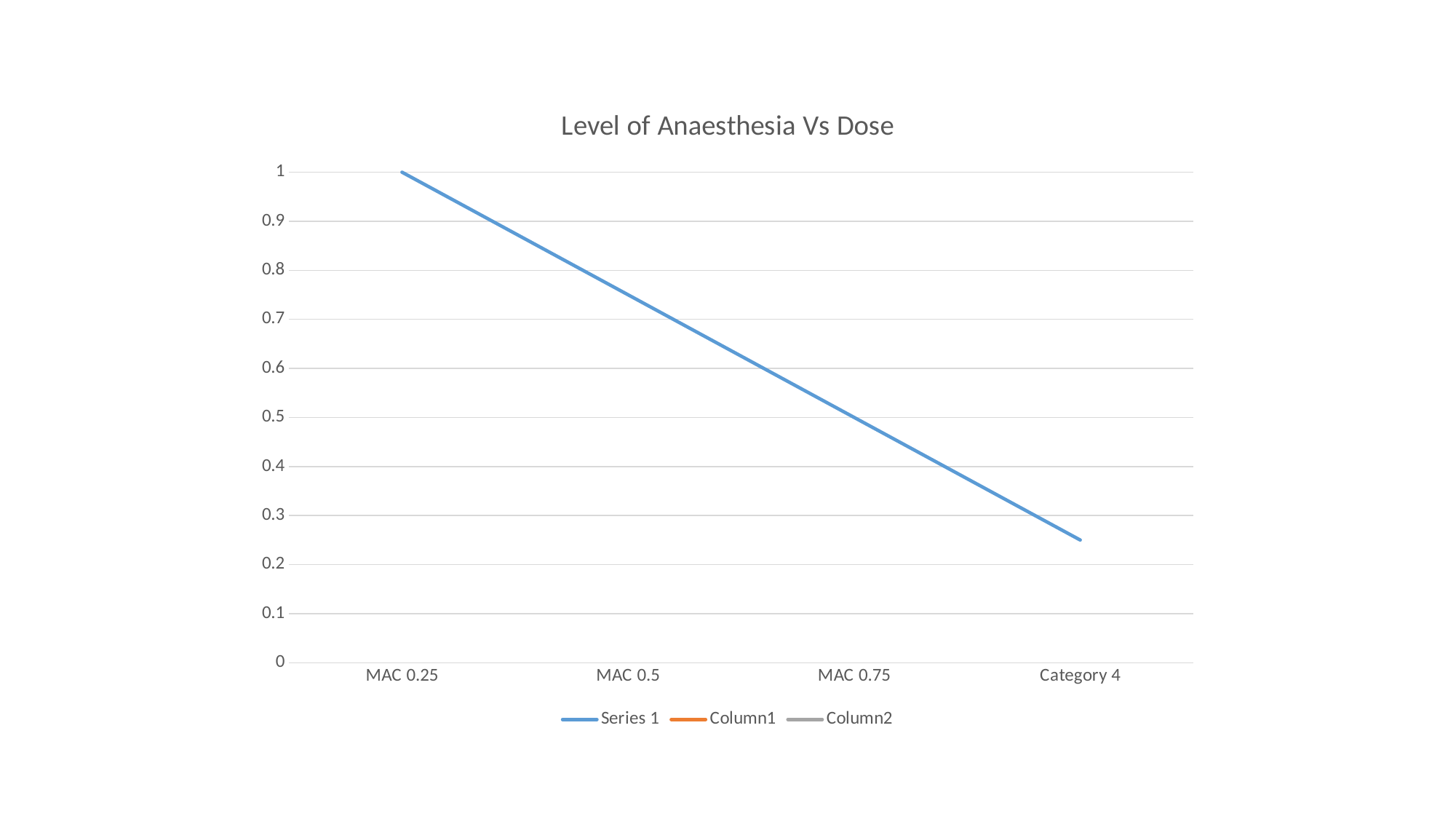
Which has the larger value, MAC 0.5 or MAC 0.75? MAC 0.5 How many categories are shown on the x axis? 4 How many series does the legend list? 3 Which category has the lowest value? Category 4 Which category has the highest value? MAC 0.25 Do the values of Series 1 rise or fall from MAC 0.25 to Category 4? fall Is the value for Category 4 greater or less than 0.3? less What is the value of Series 1 at MAC 0.25? 1 Is the value for MAC 0.5 greater or less than 0.7? greater What is the title of the chart? Level of Anaesthesia Vs Dose What kind of chart is shown on the slide? line chart What is the value of Series 1 at MAC 0.75? 0.5